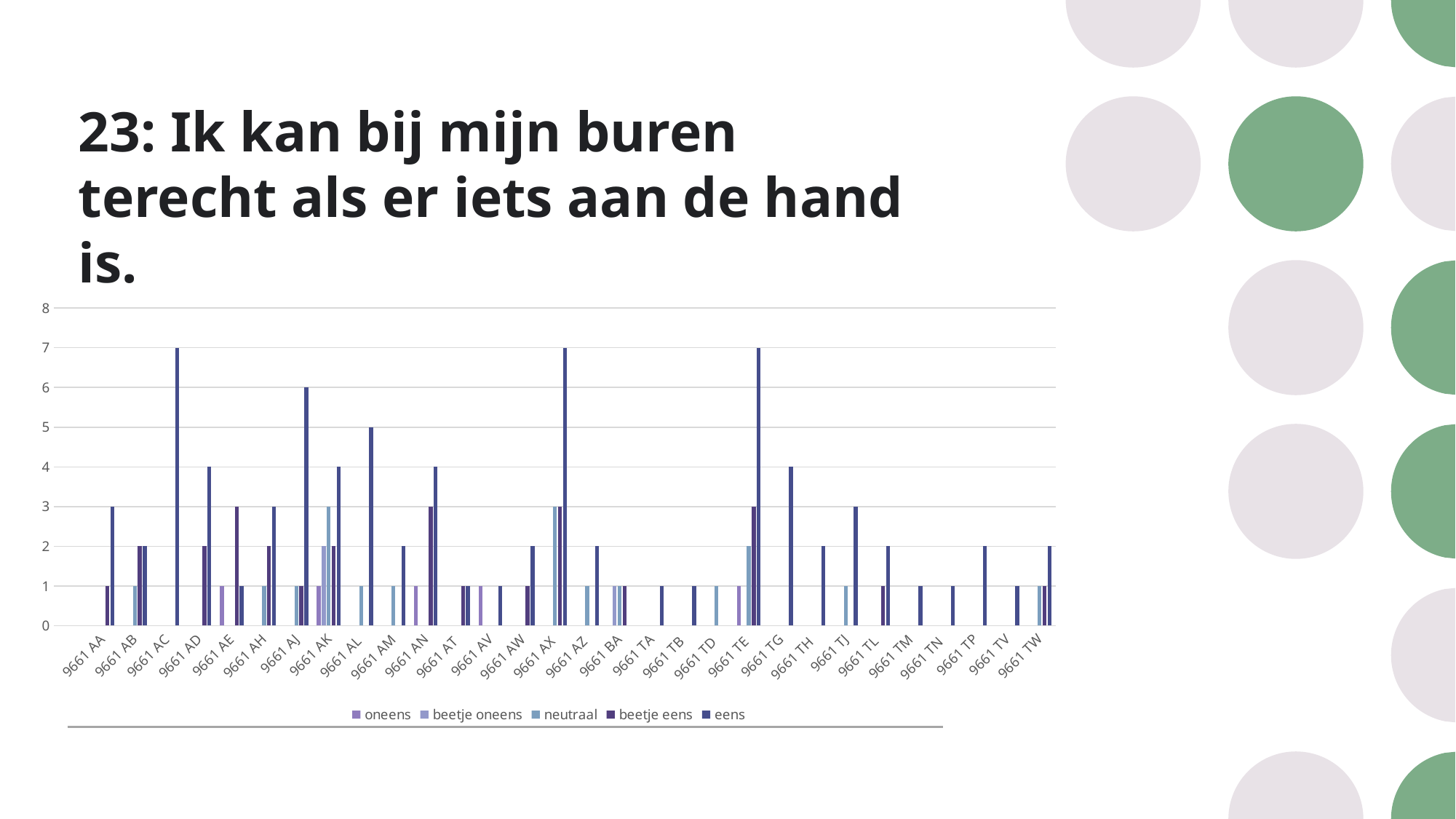
Is the tallest bar in the chart greater or less than 8? less How many series does the legend list? 5 How many categories are labelled on the x axis? 30 Is the tallest bar in the chart greater or less than 6? greater What is the highest value reached by any bar in the chart? 7 What is the first entry listed in the legend? oneens What kind of chart is shown on the slide? bar chart What is the maximum value shown on the vertical axis? 8 Which series do the tallest bars (reaching 7) belong to? eens